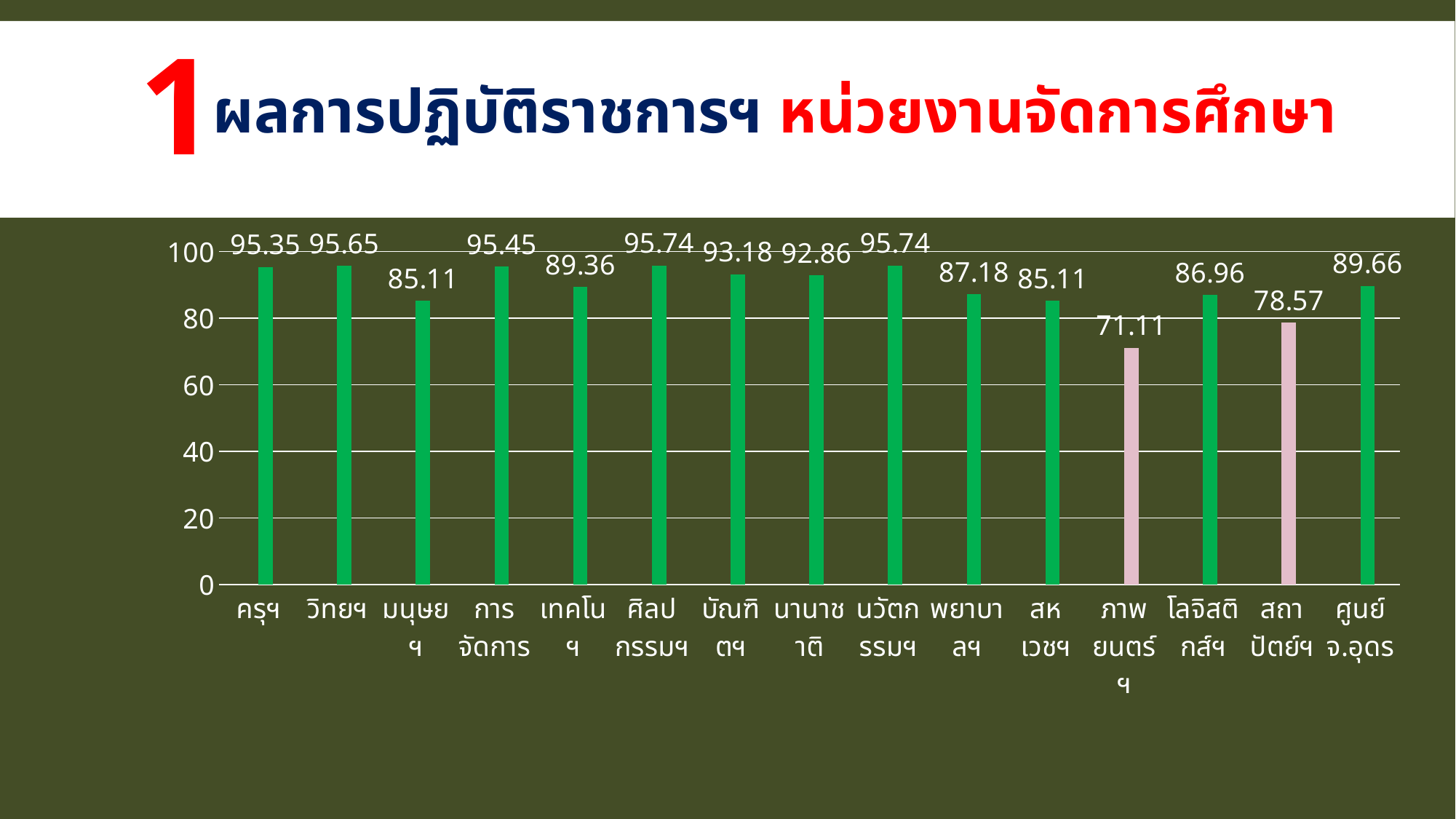
Is the value for สถาปัตย์ฯ greater or less than 80? less Which is larger, the value for พยาบาลฯ or the value for โลจิสติกส์ฯ? พยาบาลฯ What is the value for ภาพยนตร์ฯ? 71.11 What kind of chart is shown on the slide? bar chart How many bars are coloured pink rather than green? 2 What is the value for ครุฯ? 95.35 What is the value for สถาปัตย์ฯ? 78.57 What is the value for ศูนย์ จ.อุดร? 89.66 Which category has the lowest value? ภาพยนตร์ฯ How many categories are shown on the chart? 15 What is the difference between the values for วิทยฯ and ภาพยนตร์ฯ? 24.54 What is the highest value shown on the chart? 95.74